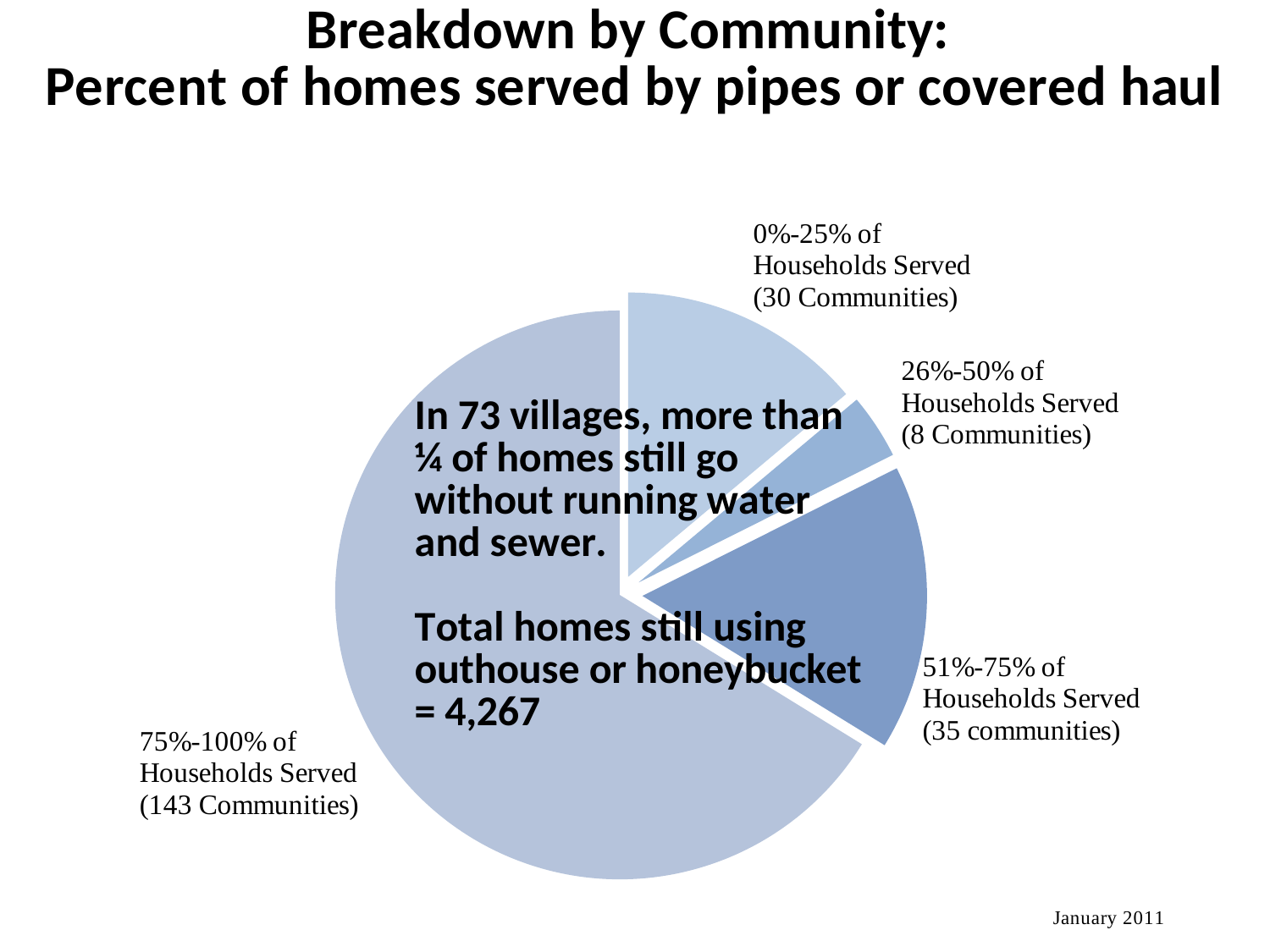
What kind of chart is shown on the slide? Pie chart How many communities have 51%-75% of households served? 35 communities How many communities have 0%-25% of households served? 30 Communities According to the text on the chart, what is the total number of homes still using an outhouse or honeybucket? 4,267 Which category has the largest number of communities? 75%-100% of Households Served Which category has the smallest number of communities? 26%-50% of Households Served Which category has more communities: 0%-25% of households served or 26%-50% of households served? 0%-25% of Households Served How many communities have 75%-100% of households served? 143 Communities How many slices does the pie chart have? 4 How many more communities are in the 51%-75% category than in the 0%-25% category? 5 What is the title of the chart on the slide? Breakdown by Community: Percent of homes served by pipes or covered haul How many communities have 26%-50% of households served? 8 Communities